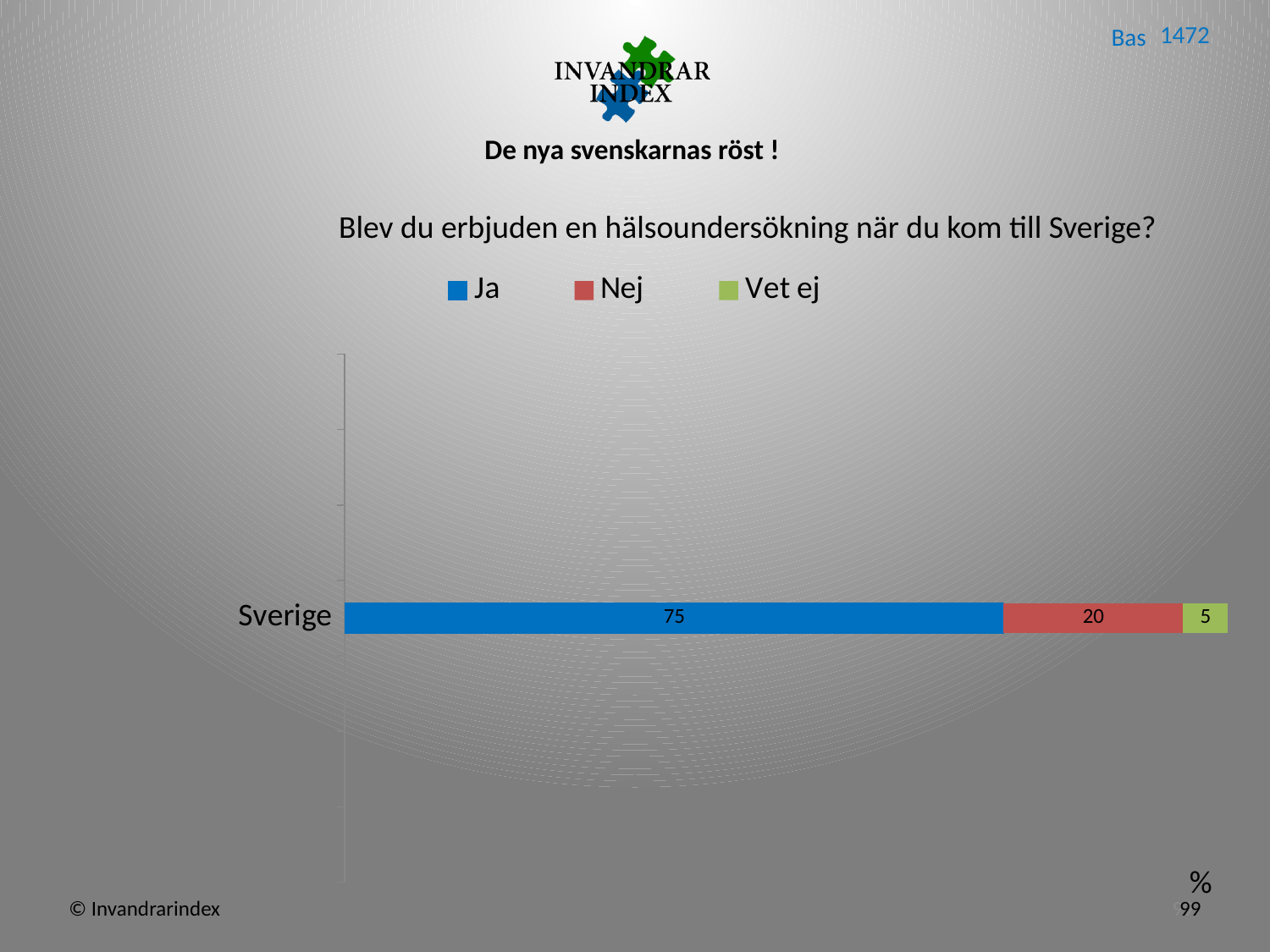
What is the title of the chart? Blev du erbjuden en hälsoundersökning när du kom till Sverige? How many categories are shown on the chart? 1 What is the value for Ja for Sverige? 75 What is the total of the stacked bar for Sverige? 100 What kind of chart is shown? Stacked bar chart How many series does the legend list? 3 What is the value for Nej for Sverige? 20 What is the difference between the Ja and Nej values for Sverige? 55 What is the value for Vet ej for Sverige? 5 Which series has the lowest value for Sverige? Vet ej Which is larger for Sverige, Nej or Vet ej? Nej Which series has the highest value for Sverige? Ja